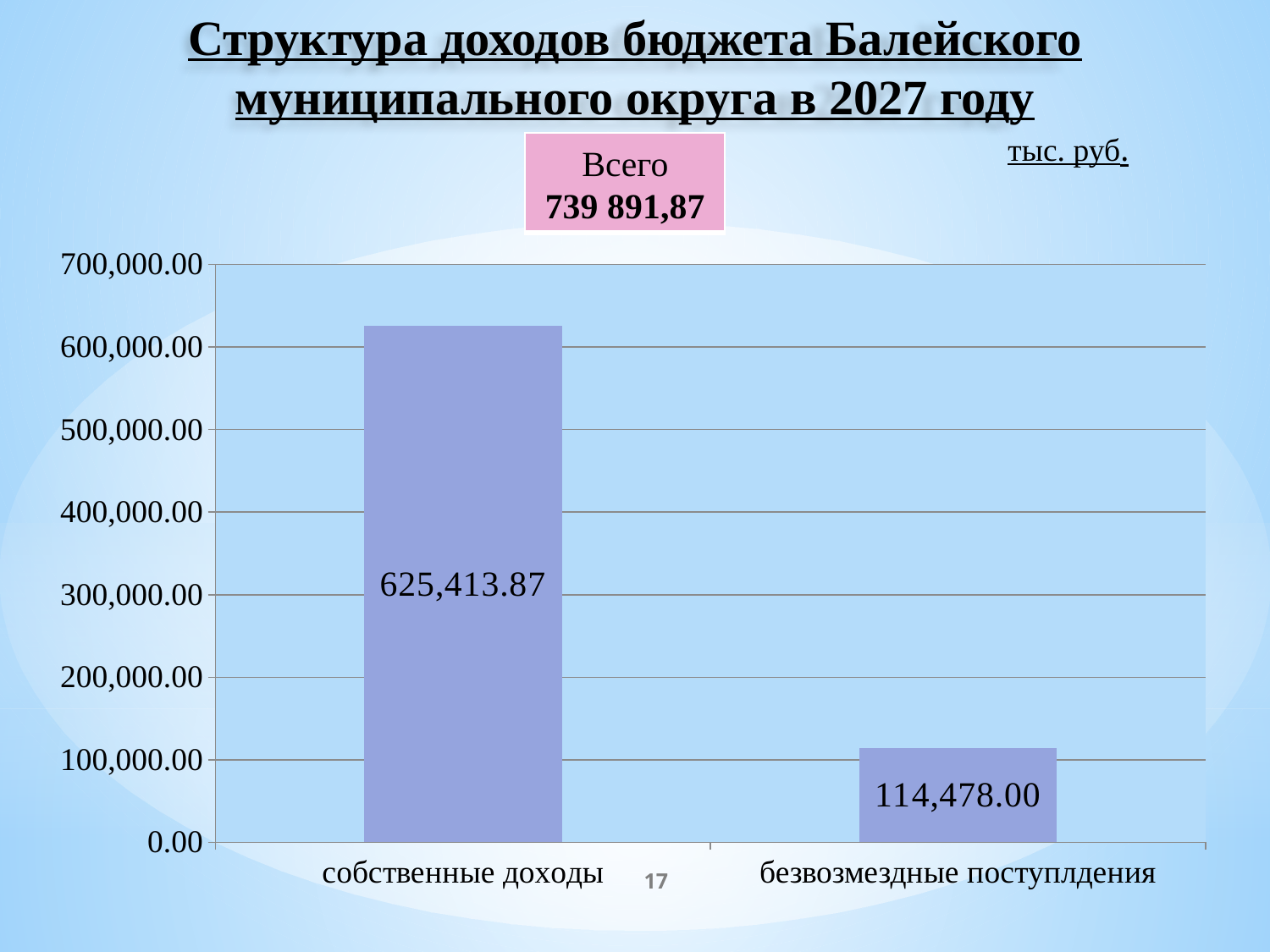
What total (Всего) is shown above the chart? 739 891,87 Is the value for собственные доходы greater or less than 600,000.00? greater How many categories are shown on the chart? 2 What is the value for собственные доходы? 625,413.87 Which category has the highest value? собственные доходы What is the difference between the values for собственные доходы and безвозмездные поступлдения? 510,935.87 What kind of chart is shown on the slide? bar chart What unit is indicated for the chart values? тыс. руб. What is the value for безвозмездные поступлдения? 114,478.00 Which category has the lowest value? безвозмездные поступлдения Is the value for безвозмездные поступлдения greater or less than 200,000.00? less Which is larger: собственные доходы or безвозмездные поступлдения? собственные доходы